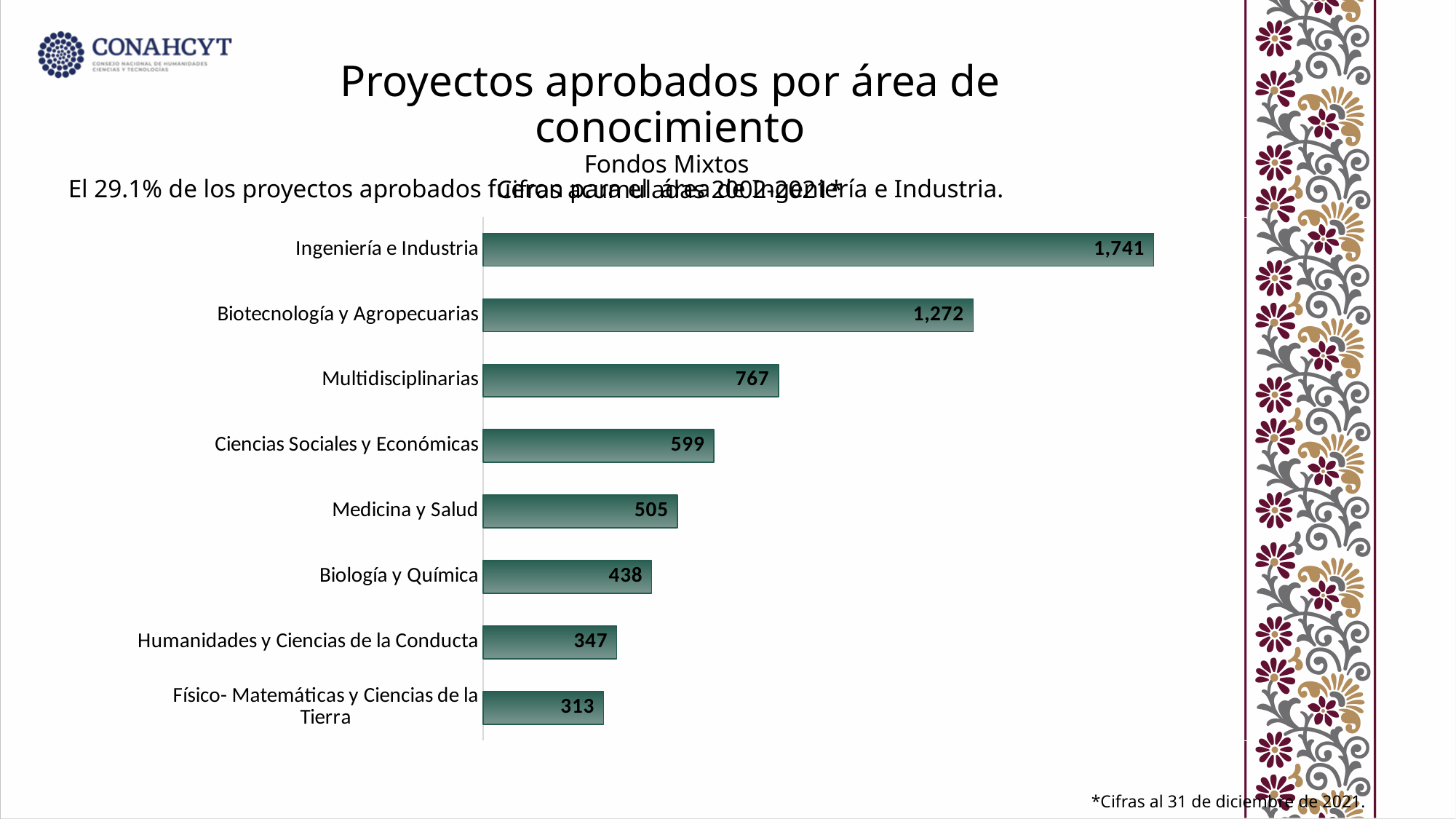
What is the value shown for Medicina y Salud? 505 What is the value shown for Multidisciplinarias? 767 How many areas of knowledge are shown in the chart? 8 What is the value shown for Físico- Matemáticas y Ciencias de la Tierra? 313 What is the difference between the values for Ingeniería e Industria and Biotecnología y Agropecuarias? 469 What is the difference between the values for Ciencias Sociales y Económicas and Biología y Química? 161 Which area of knowledge has the highest number of approved projects? Ingeniería e Industria Which area of knowledge has the lowest number of approved projects? Físico- Matemáticas y Ciencias de la Tierra How many approved projects does the chart show for Ingeniería e Industria? 1,741 What kind of chart is shown on the slide? Bar chart What is the title of the chart? Proyectos aprobados por área de conocimiento Which has a larger value, Medicina y Salud or Humanidades y Ciencias de la Conducta? Medicina y Salud